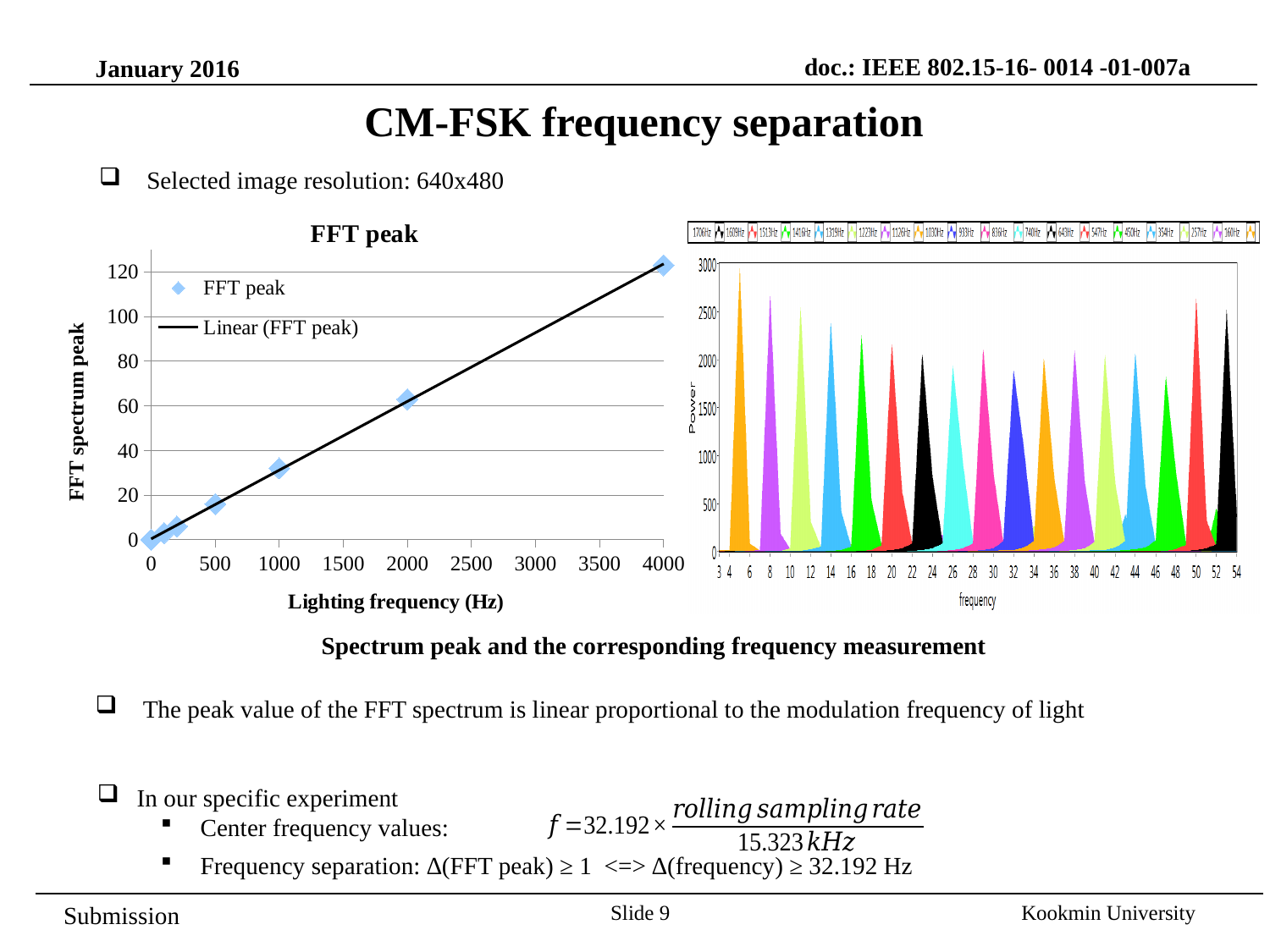
What is the y-axis label of the spectrum chart on the right of the slide? Power In the 'FFT peak' chart, do the FFT peak values rise or fall as the lighting frequency increases? rise What is the x-axis title of the 'FFT peak' chart? Lighting frequency (Hz) In the 'FFT peak' chart, is the FFT spectrum peak at 1000 Hz greater or less than 40? less What kind of chart is the 'FFT peak' chart on the left of the slide? scatter chart In the 'FFT peak' chart, is the FFT spectrum peak at 2000 Hz greater or less than 40? greater In the 'FFT peak' chart, how many entries does the legend list? 2 In the 'FFT peak' chart, is the FFT spectrum peak at 2000 Hz greater or less than 80? less In the 'FFT peak' chart, at which lighting frequency is the FFT spectrum peak highest? 4000 Hz In the 'FFT peak' chart, which has the larger FFT spectrum peak: 1000 Hz or 2000 Hz? 2000 Hz